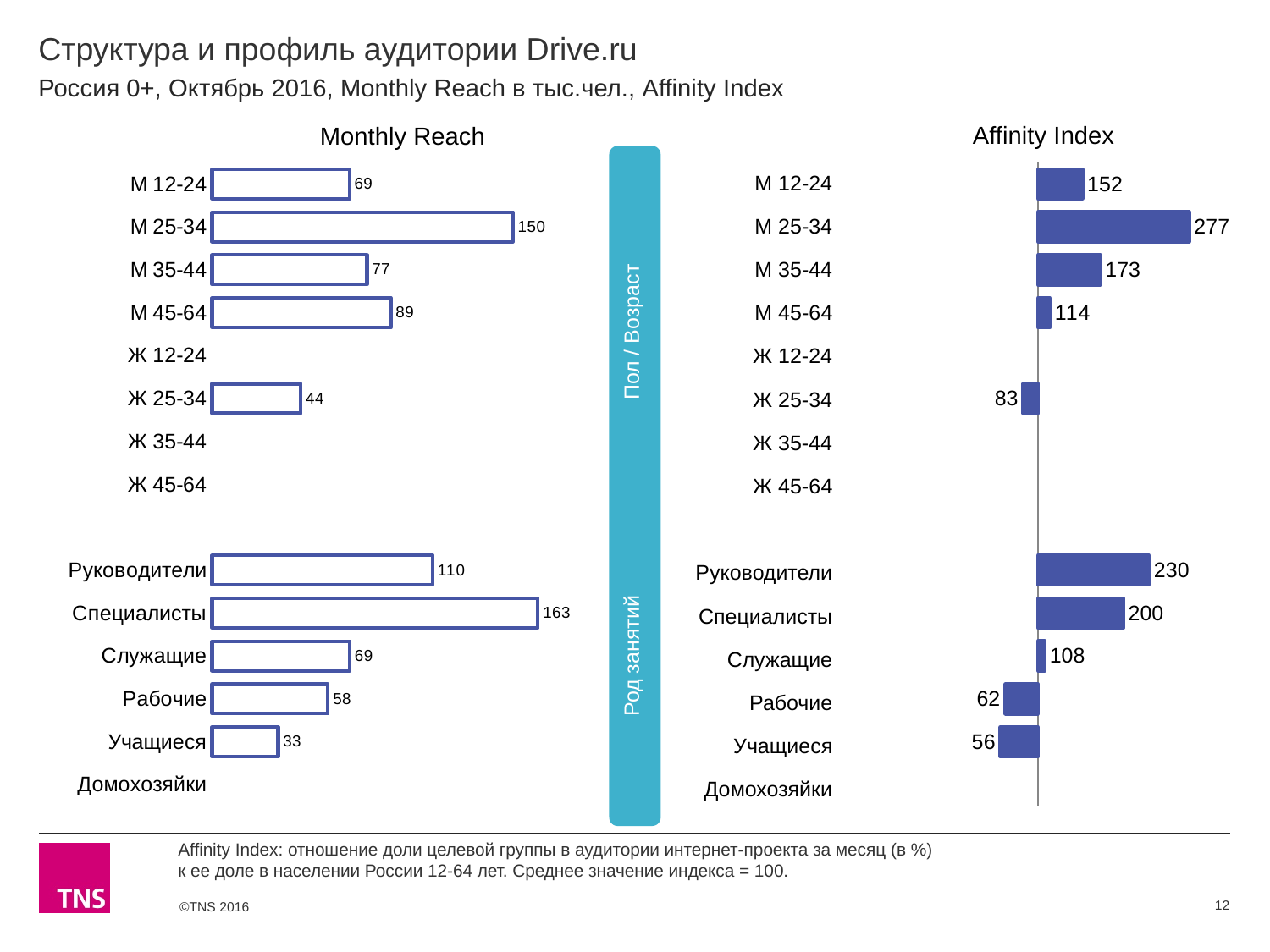
In the Affinity Index chart, what is the value for Руководители? 230 In the Monthly Reach chart, which is larger, М 45-64 or М 35-44? М 45-64 In the Monthly Reach chart, which category has the highest value? Специалисты In the Affinity Index chart, what is the value for Ж 25-34? 83 In the Monthly Reach chart, what is the difference between Специалисты and Руководители? 53 In the Monthly Reach chart, what is the value for Учащиеся? 33 What type of chart is the Monthly Reach chart? Bar chart In the Affinity Index chart, what is the difference between М 25-34 and М 35-44? 104 In the Affinity Index chart, which category has the lowest value among those with a bar? Учащиеся In the Affinity Index chart, which category has the highest value? М 25-34 In the Affinity Index chart, which is larger, Служащие or Рабочие? Служащие In the Monthly Reach chart, what is the value for М 25-34? 150